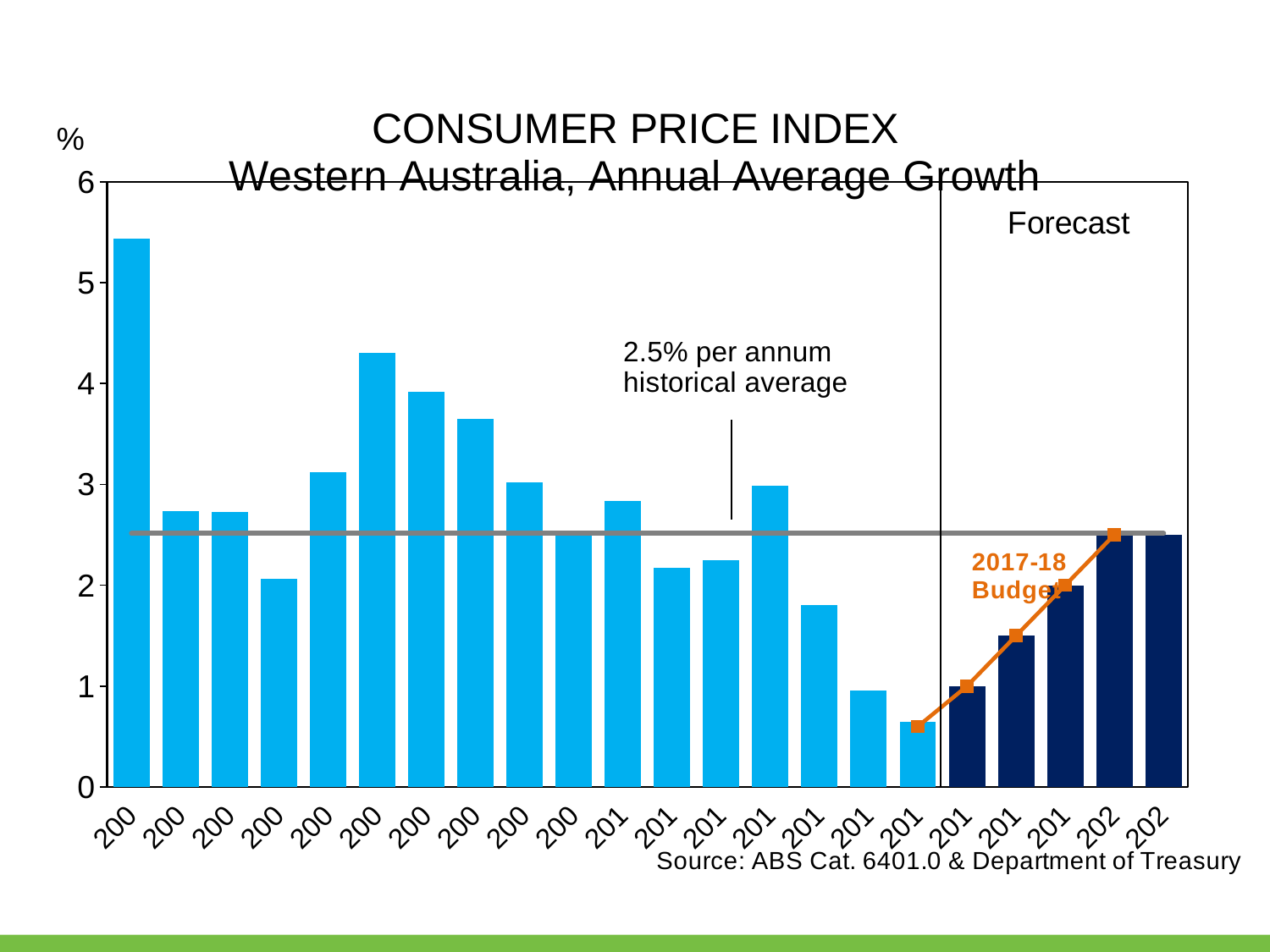
Is the value of the leftmost bar greater or less than 5? greater Which bar is the highest in the chart? the leftmost (first) bar What value does the grey horizontal line represent, according to the annotation? 2.5% per annum historical average What is the title of the chart? CONSUMER PRICE INDEX Western Australia, Annual Average Growth How many bars fall inside the Forecast box? 5 Do the bars in the Forecast region rise or fall from left to right? rise What label appears in the boxed region on the right side of the chart? Forecast Is the value of the rightmost bar greater or less than 3? less Is the value of the leftmost bar larger or smaller than the value of the rightmost bar? larger What kind of chart is shown on the slide? combination bar and line chart Is the value of the shortest bar greater or less than 1? less How many bars are plotted in the chart? 22